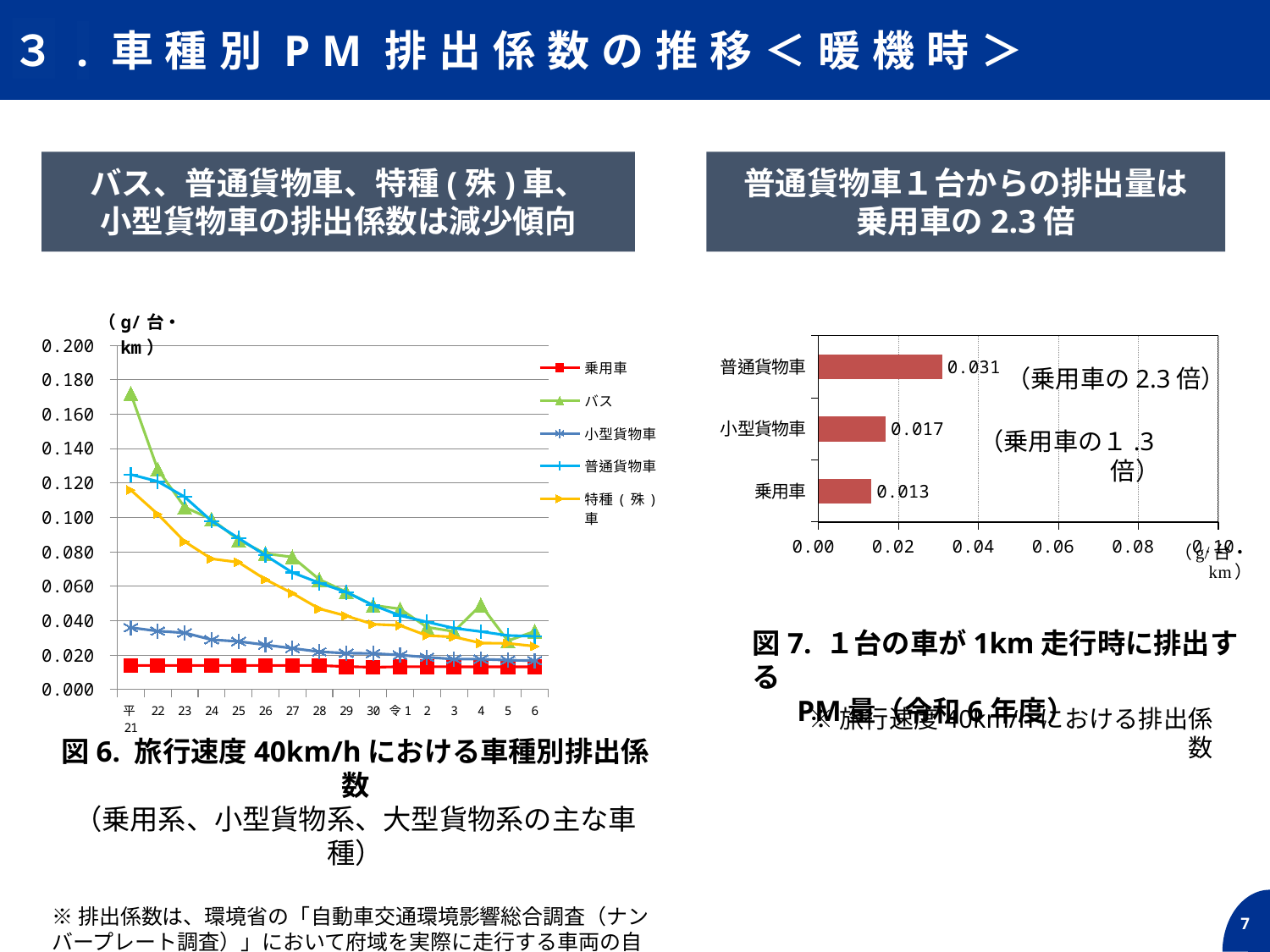
In the chart on the left (図6), does the value for バス rise or fall from 平21 to 令6? fall In the bar chart on the right (図7), what is the difference between the values for 普通貨物車 and 乗用車? 0.018 In the chart on the left (図6), is the value for バス at 平21 greater or less than 0.160? greater What kind of chart is the chart on the right (図7)? bar chart In the bar chart on the right (図7), what is the value for 普通貨物車? 0.031 In the bar chart on the right (図7), what is the value for 乗用車? 0.013 What kind of chart is the chart on the left (図6)? line chart How many series does the legend of the chart on the left (図6) list? 5 In the bar chart on the right (図7), which vehicle type has the highest value? 普通貨物車 In the bar chart on the right (図7), what is the value for 小型貨物車? 0.017 How many vehicle categories are shown in the bar chart on the right (図7)? 3 In the bar chart on the right (図7), which vehicle type has the lowest value? 乗用車